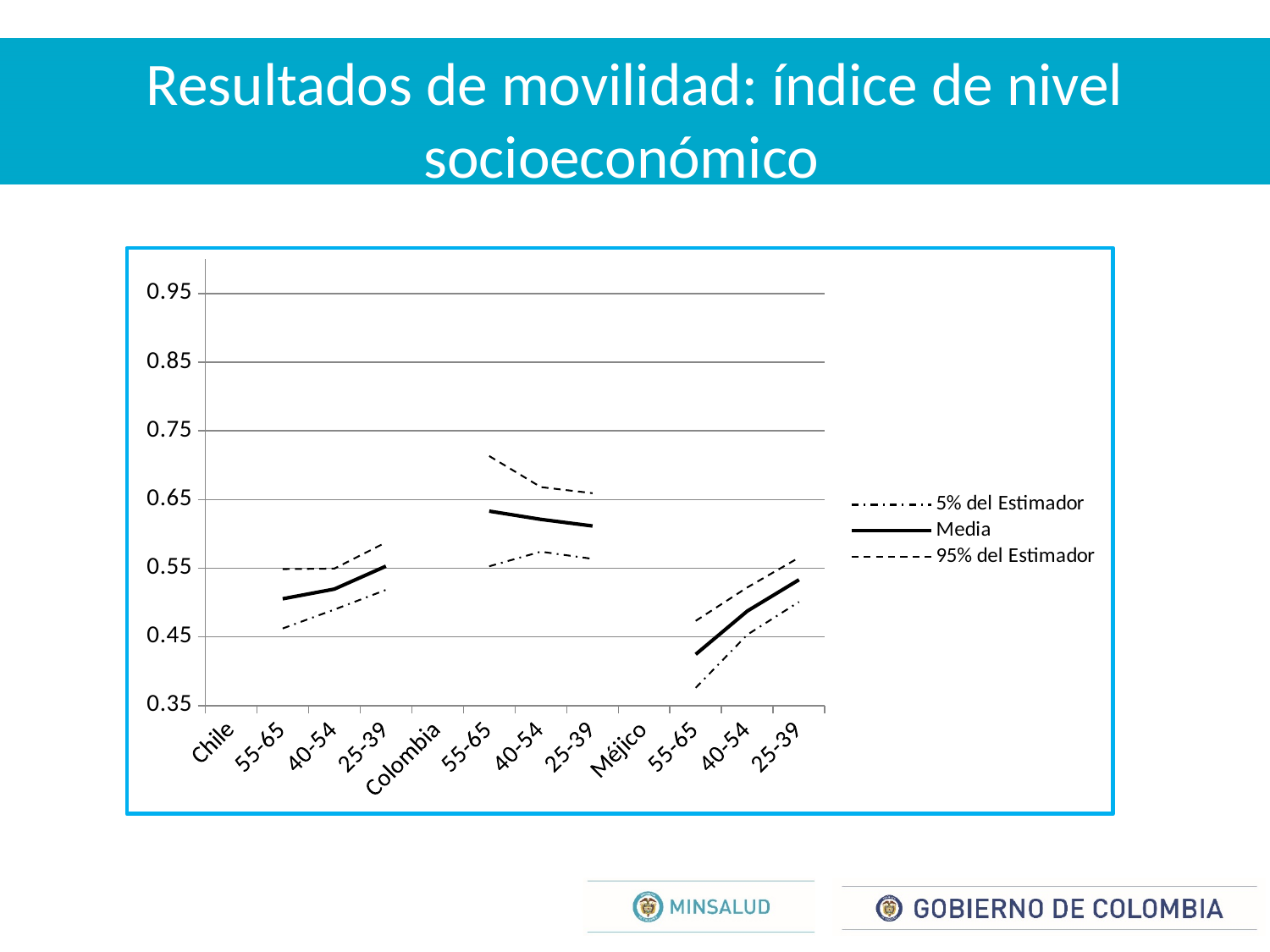
Is the Media value for the Chile 55-65 group greater or less than 0.55? less Which country has the highest Media values: Chile, Colombia or Méjico? Colombia What are the three series listed in the legend? 5% del Estimador, Media, 95% del Estimador Which is larger, the Media value for Colombia 55-65 or for Chile 55-65? Colombia 55-65 Is the Media value for the Méjico 55-65 group greater or less than 0.45? less Is the Media value for the Colombia 55-65 group greater or less than 0.55? greater Does the Media line rise or fall across the Méjico age groups from 55-65 to 25-39? rise What kind of chart is shown on the slide? line chart How many category labels are shown along the x axis? 12 How many series does the legend list? 3 Does the Media line rise or fall across the Colombia age groups from 55-65 to 25-39? fall